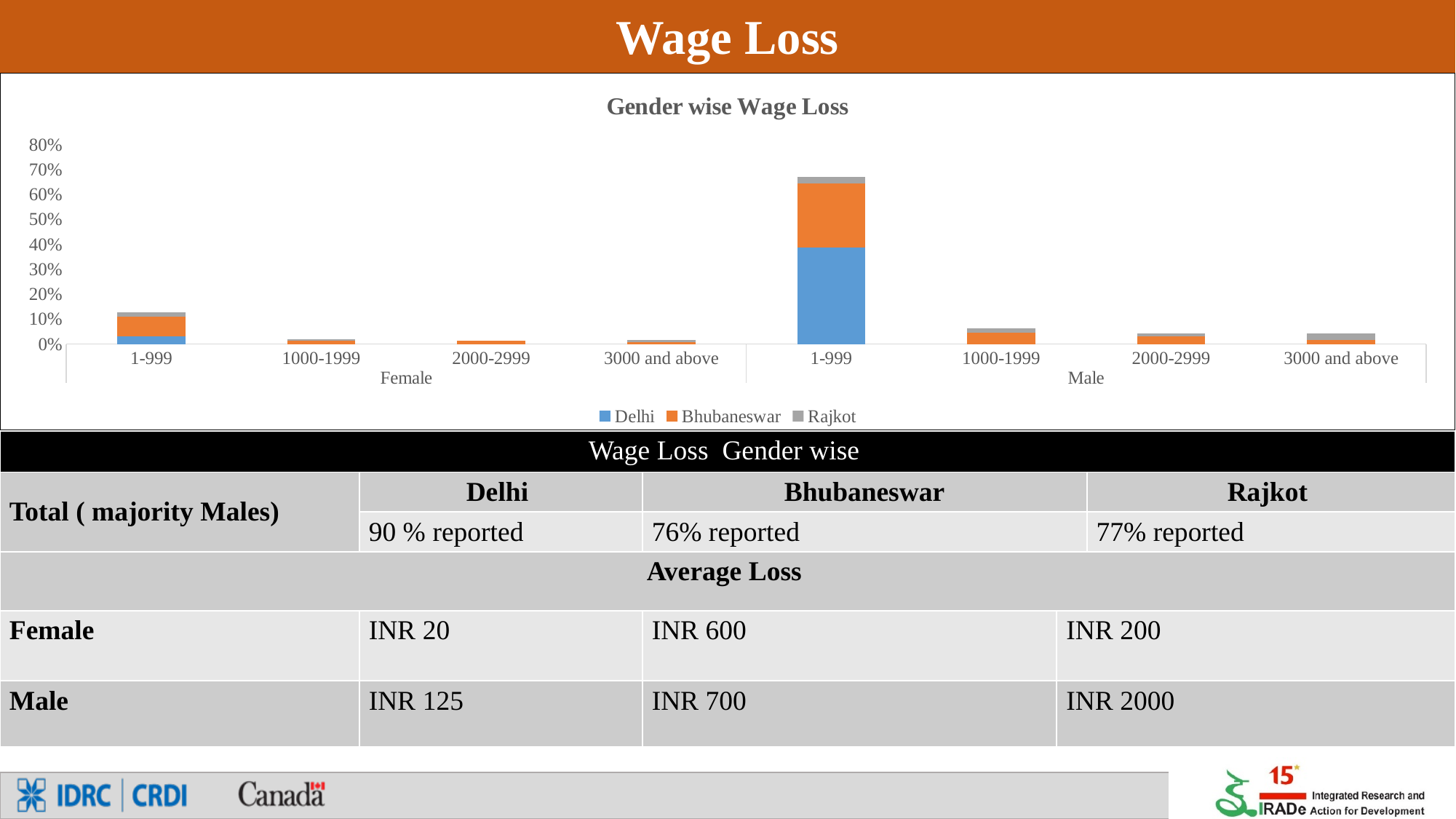
How many series does the legend of the "Gender wise Wage Loss" chart list? 3 Is the Delhi segment of the Male 1-999 bar greater or less than 30%? greater Which series are listed in the legend of the "Gender wise Wage Loss" chart? Delhi, Bhubaneswar, Rajkot Which stacked bar is taller: Female 1-999 or Male 1-999? Male 1-999 What kind of chart is shown under the title "Gender wise Wage Loss"? Stacked bar chart Which colour represents Bhubaneswar in the "Gender wise Wage Loss" chart? Orange Is the total stacked value for Female 1-999 greater or less than 20%? less Which category has the tallest stacked bar in the "Gender wise Wage Loss" chart? Male 1-999 Is the total stacked value for Female 1-999 greater or less than 10%? greater How many bars are plotted in the "Gender wise Wage Loss" chart? 8